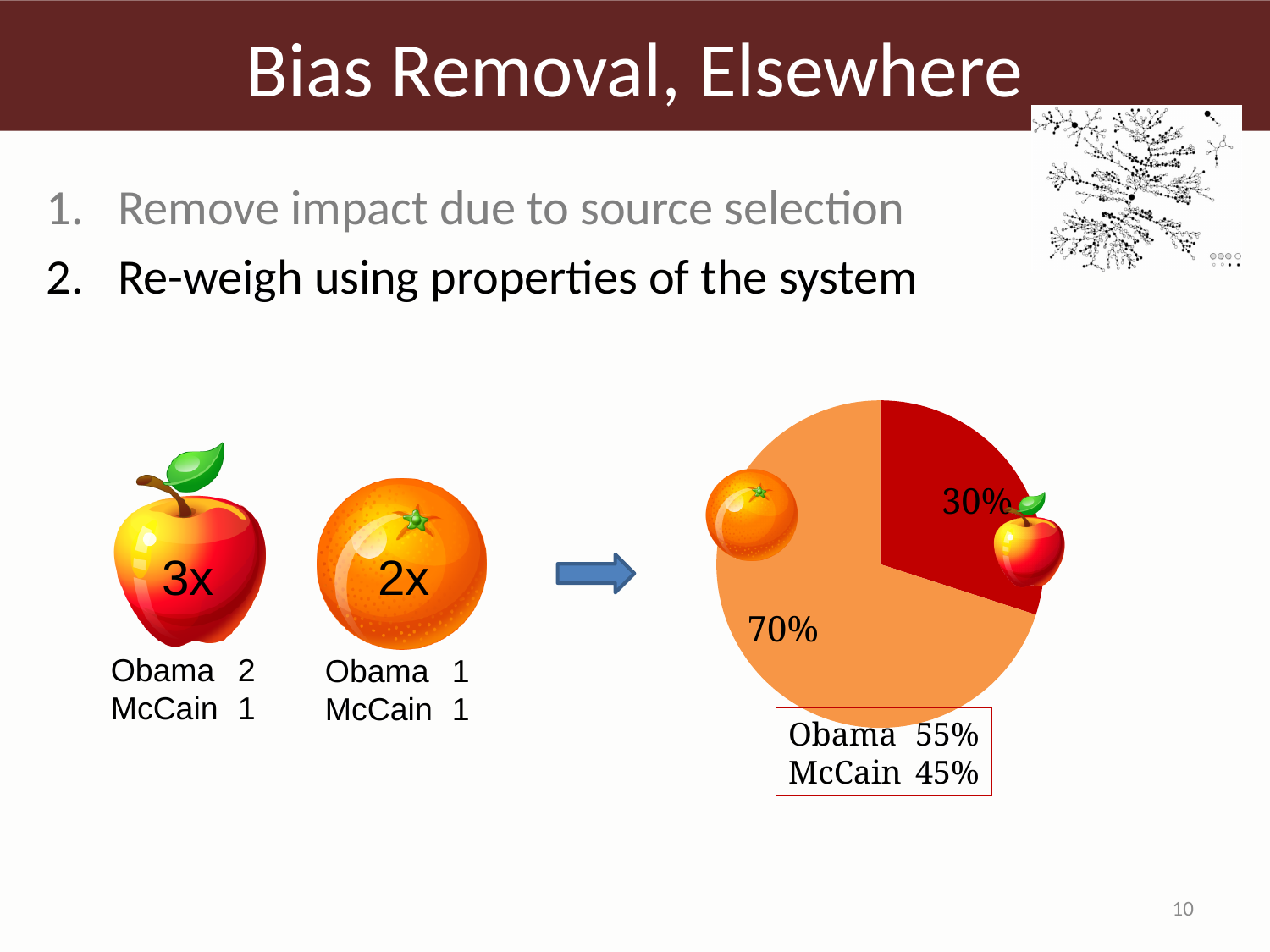
What is the title of the slide containing the pie chart? Bias Removal, Elsewhere What percentage is shown on the larger, orange-coloured slice of the pie chart? 70% Is the share of the red slice in the pie chart greater or less than 50%? less What is the difference in percentage points between the two slices of the pie chart? 40 What colour is the slice of the pie chart labelled 30%? red What percentage is shown on the red slice of the pie chart (the one marked with an apple)? 30% How many slices does the pie chart have? 2 What is the total of the two percentages shown on the pie chart? 100% Which slice of the pie chart is larger, the one marked with an orange or the one marked with an apple? the one marked with an orange In the box below the pie chart, what percentage is given for Obama? 55% What kind of chart is shown on the right side of the slide? pie chart In the box below the pie chart, what percentage is given for McCain? 45%